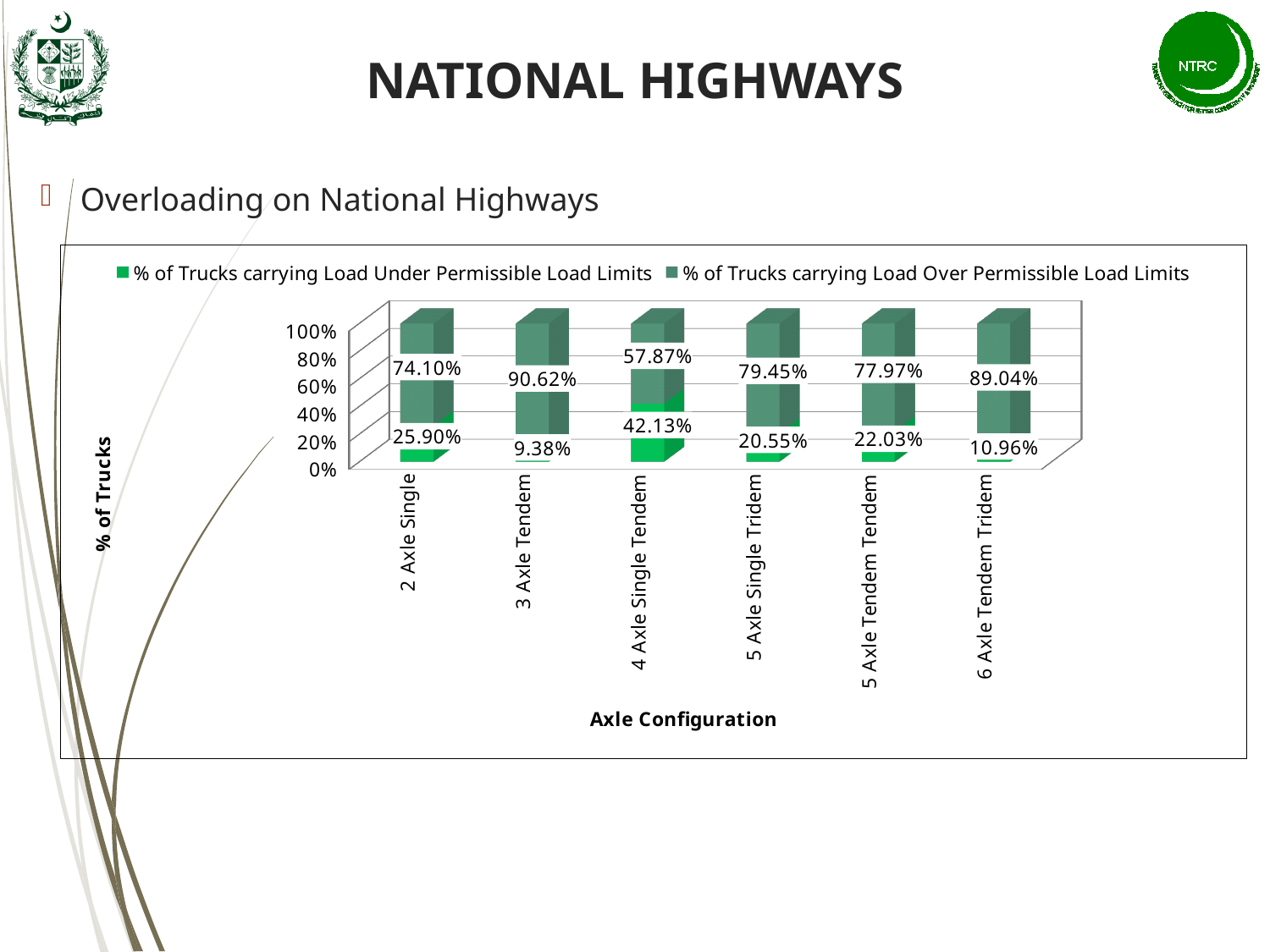
Which is larger: the percentage of 5 Axle Single Tridem trucks under permissible limits or the percentage of 5 Axle Tendem Tendem trucks under permissible limits? 5 Axle Tendem Tendem What percentage of 2 Axle Single trucks carry load over permissible load limits? 74.10% What percentage of 4 Axle Single Tendem trucks carry load over permissible load limits? 57.87% How many series does the legend list? 2 Which axle configuration has the lowest percentage of trucks carrying load under permissible load limits? 3 Axle Tendem What is the difference between the percentage of 5 Axle Tendem Tendem trucks over permissible limits and the percentage under permissible limits? 55.94% What type of chart is shown on the slide? Stacked bar chart How many axle configurations are shown on the x axis? 6 Which axle configuration has the highest percentage of trucks carrying load under permissible load limits? 4 Axle Single Tendem What percentage of 3 Axle Tendem trucks carry load under permissible load limits? 9.38% What percentage of 6 Axle Tendem Tridem trucks carry load under permissible load limits? 10.96% Which axle configuration has the highest percentage of trucks carrying load over permissible load limits? 3 Axle Tendem